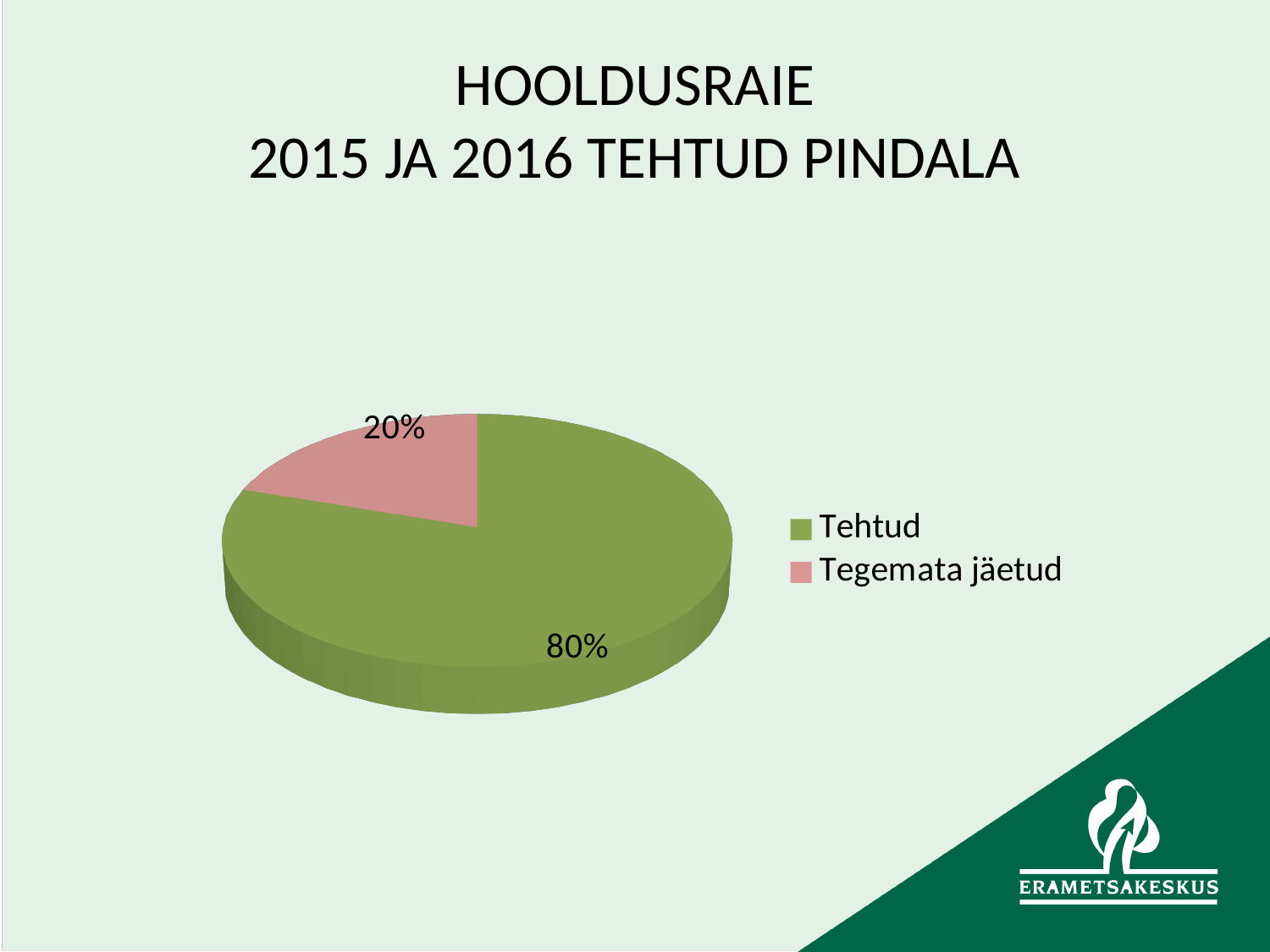
Which category has the largest slice of the pie? Tehtud Which category has the smallest slice of the pie? Tegemata jäetud What kind of chart is shown on the slide? Pie chart How many categories are shown in the pie chart? 2 What colour is the Tegemata jäetud slice? Pink What is the title of the slide containing the chart? HOOLDUSRAIE 2015 JA 2016 TEHTUD PINDALA How many entries does the legend list? 2 What share of the pie does Tegemata jäetud represent? 20% What share of the pie does Tehtud represent? 80% What is the difference in percentage points between Tehtud and Tegemata jäetud? 60 Which is larger, the share for Tehtud or the share for Tegemata jäetud? Tehtud